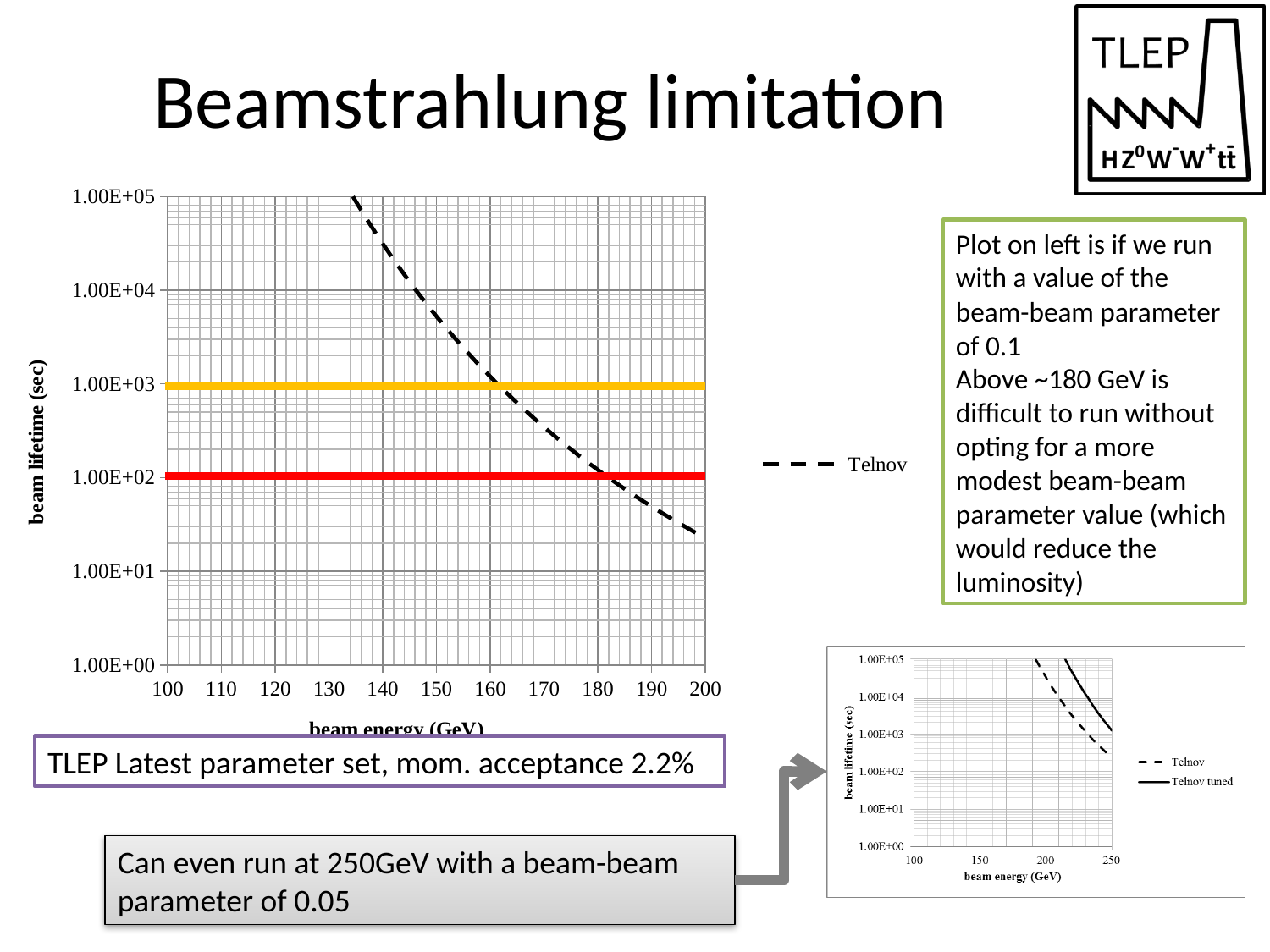
In the large chart on the left, does the Telnov beam lifetime rise or fall as beam energy increases? fall In the large chart on the left, is the Telnov beam lifetime at 170 GeV greater or less than 1.00E+02? greater How many series does the legend of the small chart at the bottom right list? 2 In the large chart on the left, is the Telnov beam lifetime at 140 GeV greater or less than 1.00E+04? greater In the large chart on the left, is the Telnov beam lifetime at 200 GeV greater or less than 1.00E+02? less In the small chart at the bottom right, does the Telnov tuned beam lifetime rise or fall as beam energy increases? fall How many series does the legend of the large chart on the left list? 1 What is the x-axis label of the large chart on the left? beam energy (GeV) What kind of chart is the large chart on the left of the slide? line chart In the small chart at the bottom right, which series has the higher beam lifetime at 250 GeV, Telnov or Telnov tuned? Telnov tuned What are the two legend entries of the small chart at the bottom right? Telnov and Telnov tuned